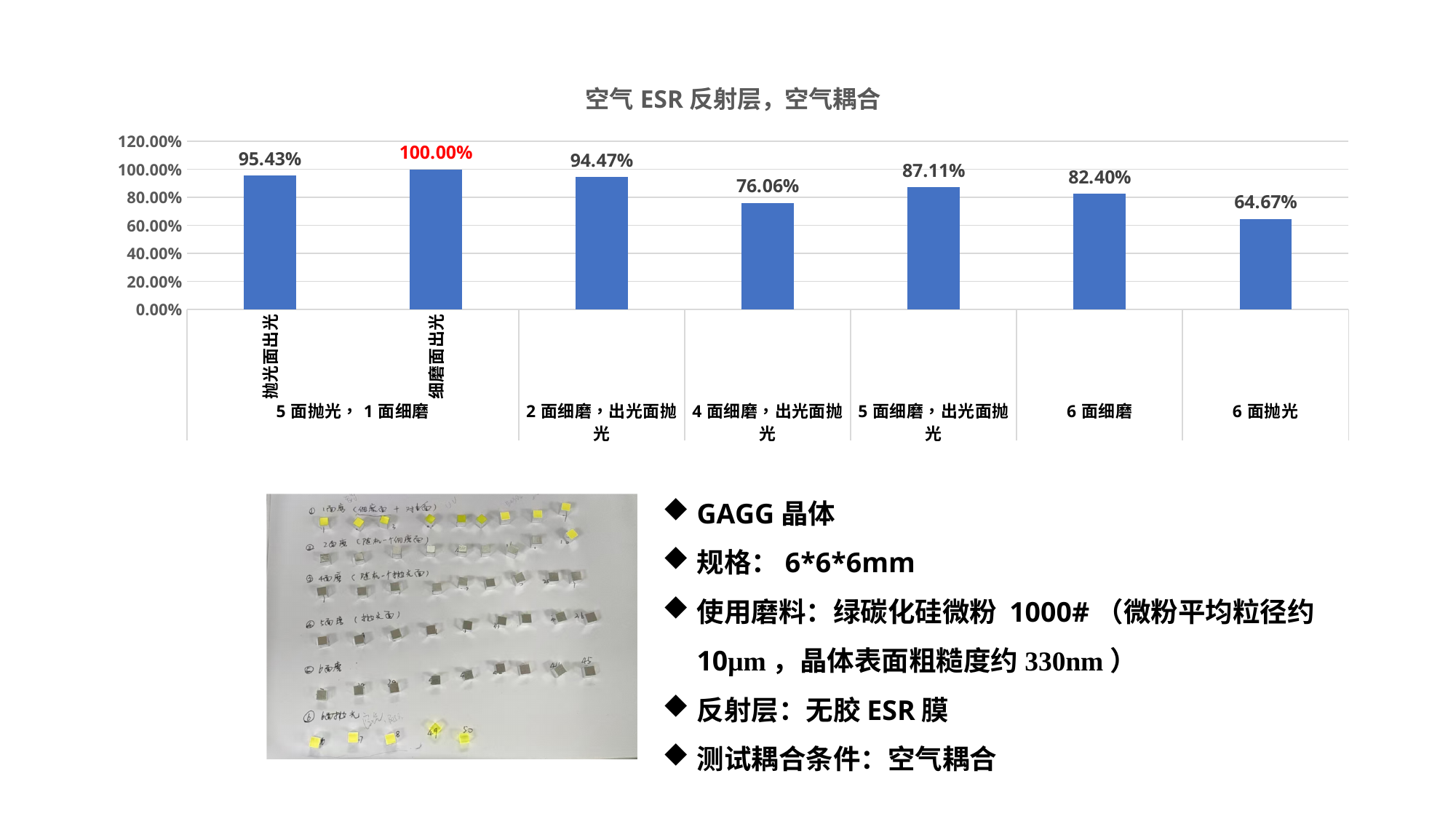
What is the difference between the 抛光面出光 and 细磨面出光 bars under 5 面抛光，1 面细磨? 4.57% What is the difference between the values for 5 面细磨，出光面抛光 and 6 面细磨? 4.71% How many bars are plotted in the chart? 7 What is the value for 6 面细磨? 82.40% What is the title of the chart? 空气 ESR 反射层，空气耦合 Which bar has the lowest value? 6 面抛光 Which is larger, the value for 2 面细磨，出光面抛光 or the value for 4 面细磨，出光面抛光? 2 面细磨，出光面抛光 What is the value for 4 面细磨，出光面抛光? 76.06% Which bar has the highest value? 细磨面出光 (5 面抛光，1 面细磨) What is the value for 6 面抛光? 64.67% What is the value for the 细磨面出光 bar under 5 面抛光，1 面细磨? 100.00% What type of chart is shown on the slide? bar chart